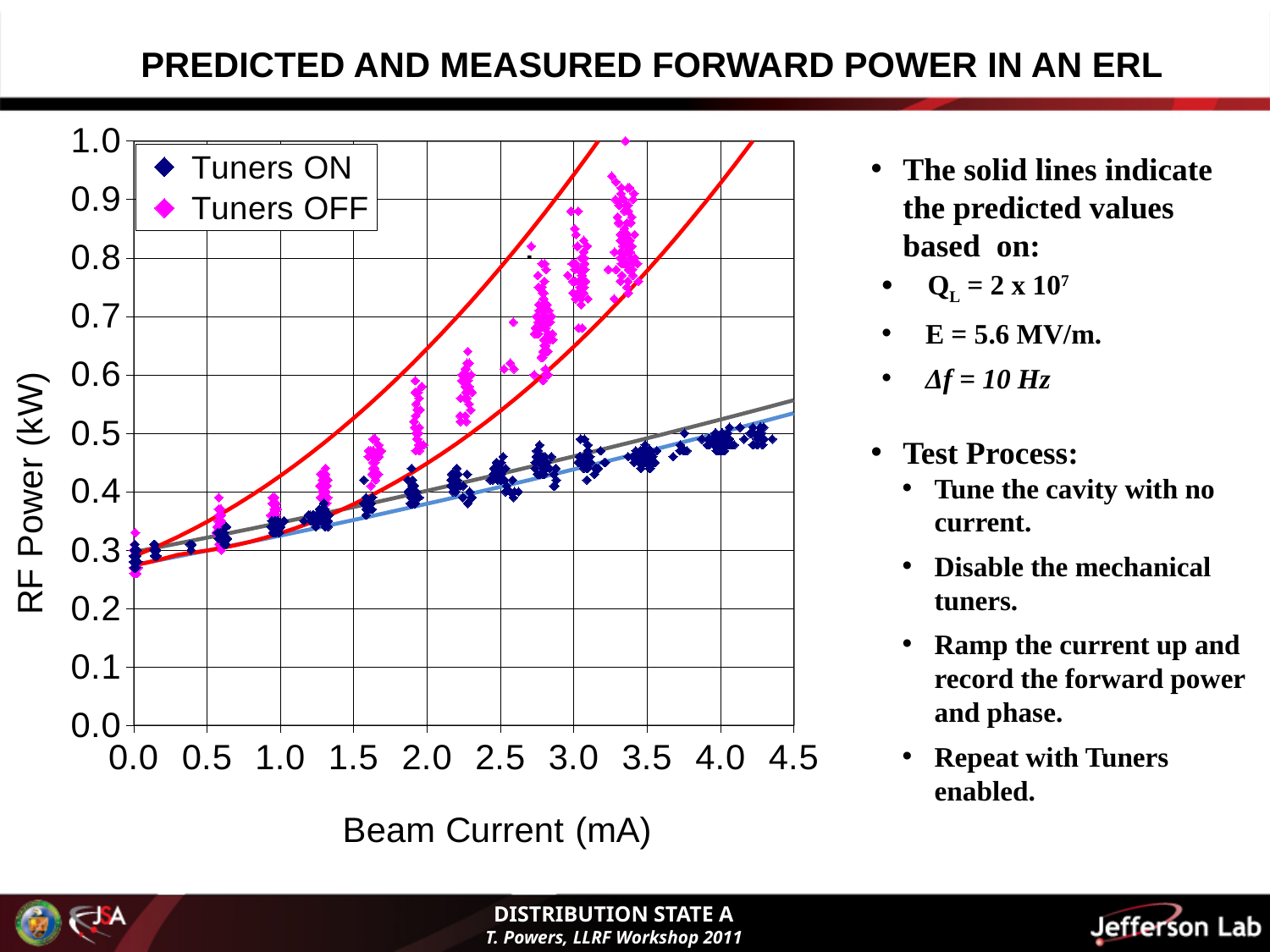
At a beam current of about 3.0 mA, which series shows the higher RF power, Tuners ON or Tuners OFF? Tuners OFF Is the RF power for the Tuners OFF series at 3.0 mA greater or less than 0.6 kW? greater How many series does the chart legend list? 2 Does the RF power for the Tuners OFF series rise or fall as beam current increases? rise What is the label of the chart's x axis? Beam Current (mA) Is the RF power for the Tuners OFF series at 2.0 mA greater or less than 0.4 kW? greater What kind of chart is shown on the slide? scatter chart Is the RF power for the Tuners ON series at 4.0 mA greater or less than 0.6 kW? less Does the RF power for the Tuners ON series rise or fall as beam current increases? rise Which series reaches the highest RF power on the chart? Tuners OFF What are the two series named in the chart legend? Tuners ON and Tuners OFF